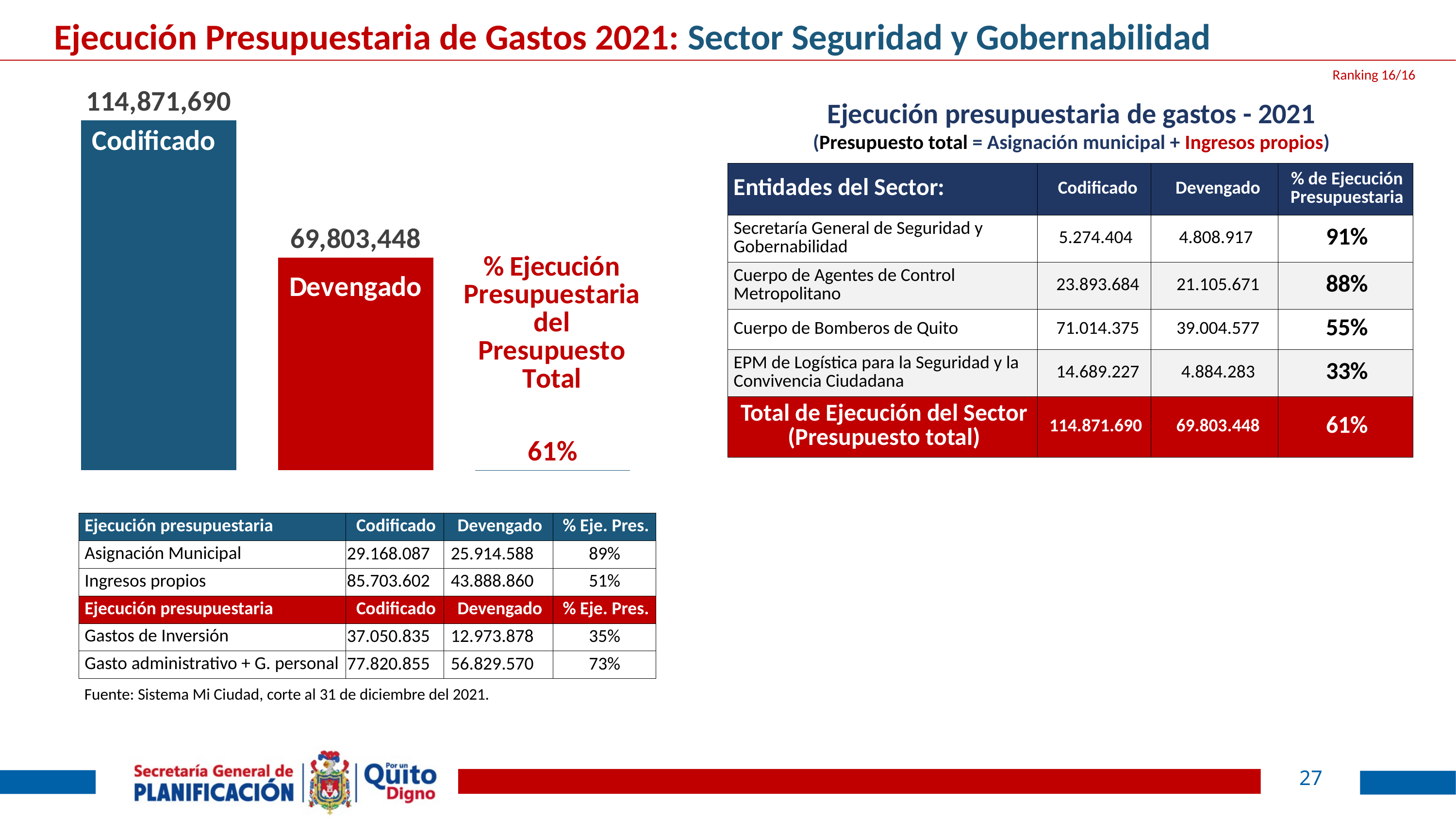
What percentage is shown next to the bar chart as the % Ejecución Presupuestaria del Presupuesto Total? 61% What value is shown for the Codificado bar in the bar chart? 114,871,690 What value is shown for the Devengado bar in the bar chart? 69,803,448 Which bar in the chart is the highest? Codificado Which is larger in the bar chart, Codificado or Devengado? Codificado What colour is the Devengado bar in the chart? Red What is the difference between the Codificado and Devengado values in the bar chart? 45,068,242 What kind of chart is shown on the left of the slide? Bar chart How many bars are plotted in the chart? 2 Which bar in the chart is the lowest? Devengado